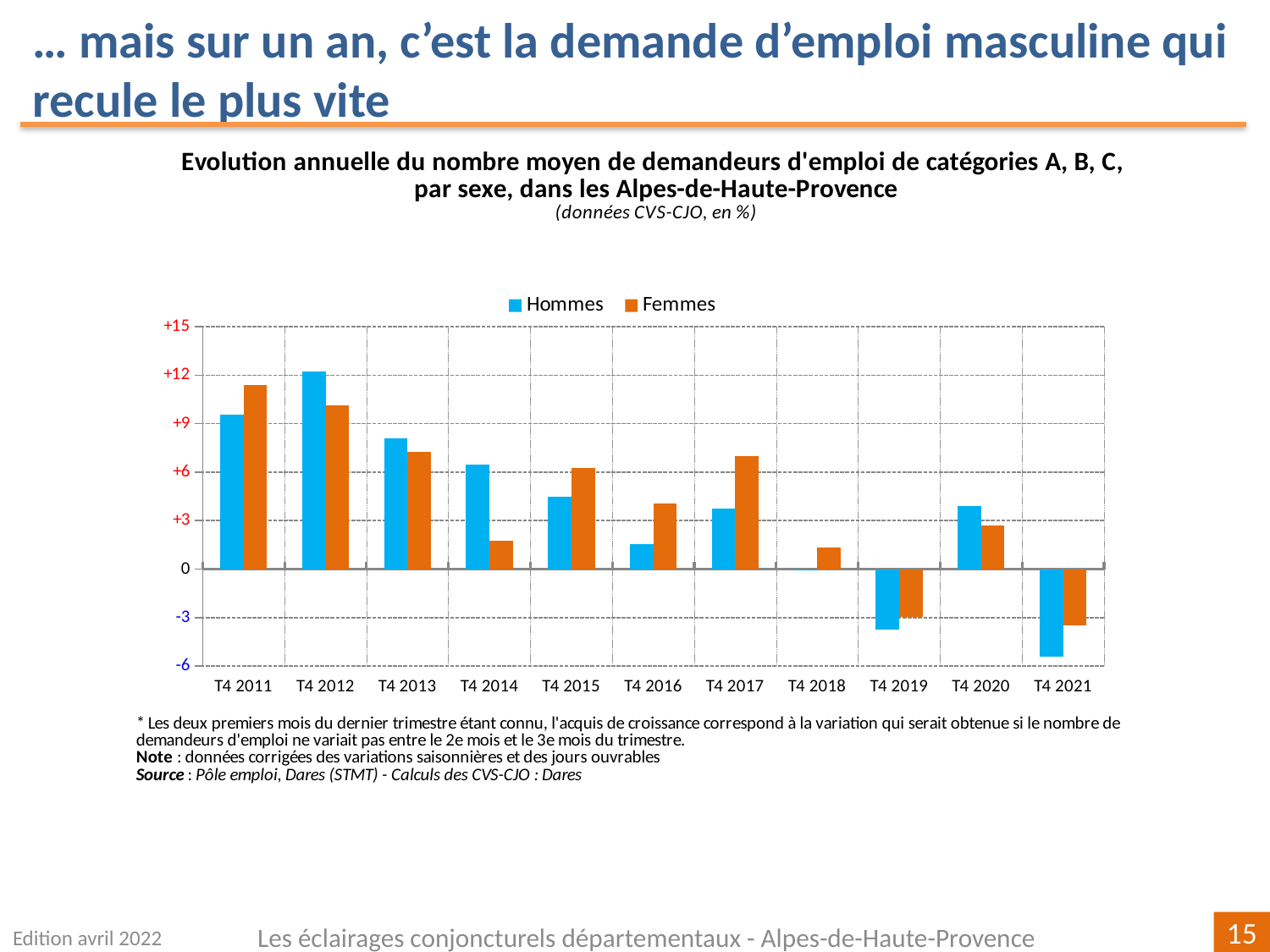
In which quarter is the Femmes value highest? T4 2011 How many series does the legend list? 2 What kind of chart is shown on the slide? bar chart In which quarter is the Femmes value lowest? T4 2021 In which quarter is the Hommes value lowest? T4 2021 In T4 2014, which series has the larger value, Hommes or Femmes? Hommes Is the Hommes value for T4 2021 greater or less than -3? less In T4 2017, which series has the larger value, Hommes or Femmes? Femmes In which quarter is the Hommes value highest? T4 2012 How many quarters are shown on the x axis? 11 Do the Femmes values rise or fall from T4 2011 to T4 2014? fall Is the Femmes value for T4 2014 greater or less than +3? less